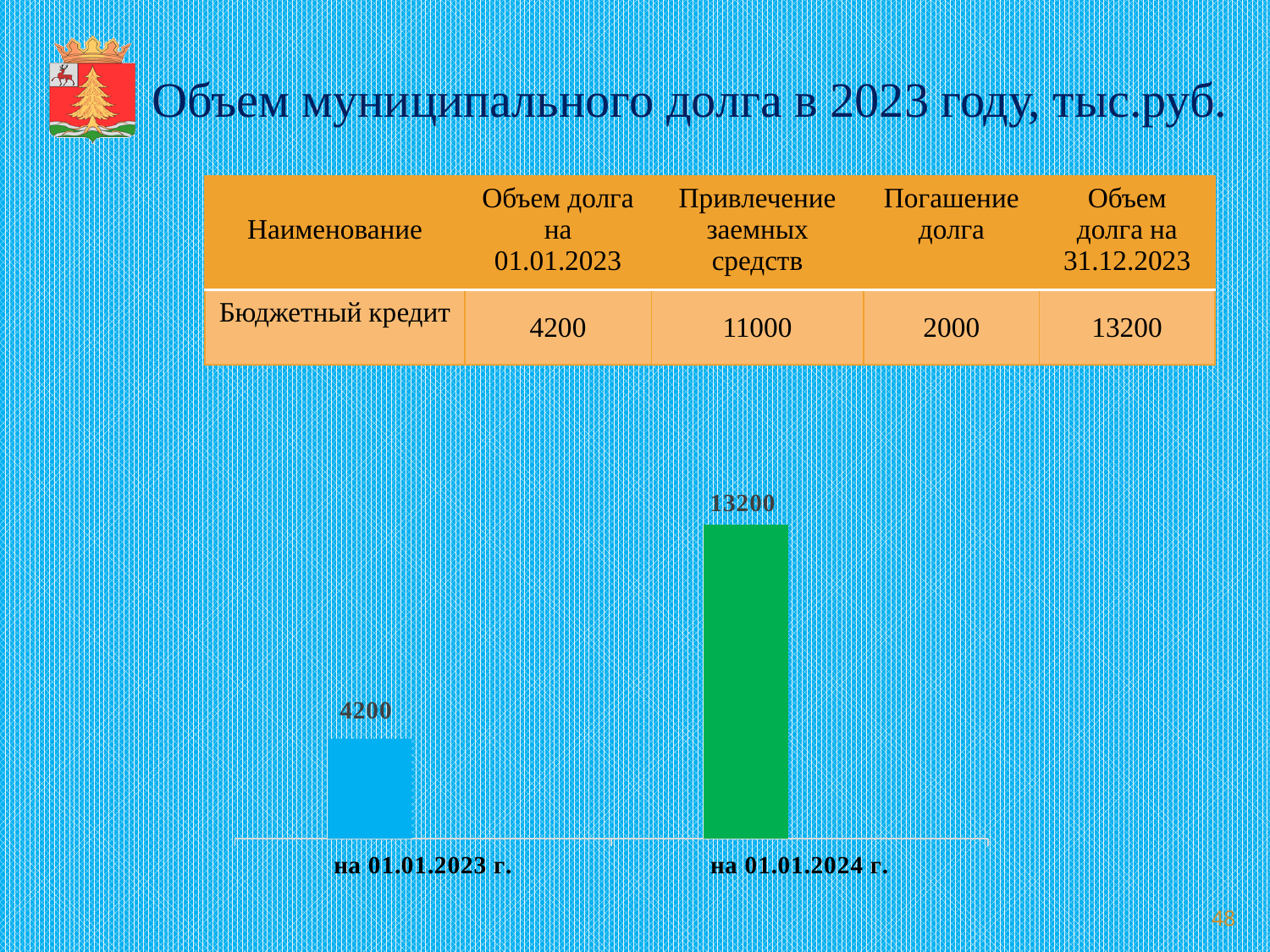
What colour is the bar for "на 01.01.2023 г."? blue Which category has the highest bar in the chart? на 01.01.2024 г. Which category has the lowest bar in the chart? на 01.01.2023 г. What is the difference between the values for "на 01.01.2024 г." and "на 01.01.2023 г."? 9000 What kind of chart is shown on the slide? bar chart Which is larger: the value for "на 01.01.2023 г." or the value for "на 01.01.2024 г."? на 01.01.2024 г. What is the value of the bar for "на 01.01.2024 г."? 13200 Do the values rise or fall from "на 01.01.2023 г." to "на 01.01.2024 г."? rise How many bars are shown in the chart? 2 What colour is the bar for "на 01.01.2024 г."? green What is the value of the bar for "на 01.01.2023 г."? 4200